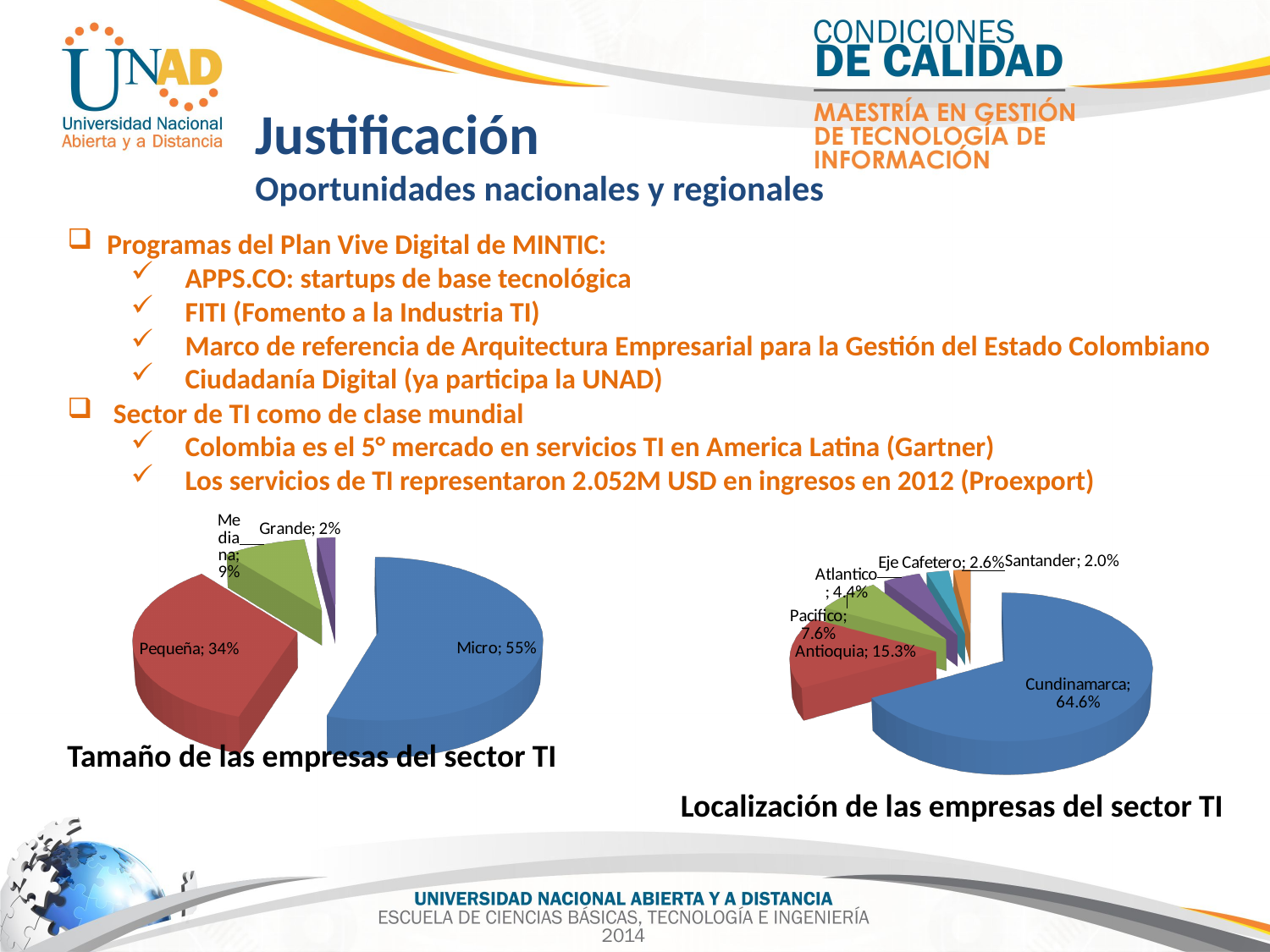
In the 'Tamaño de las empresas del sector TI' chart, what is the value for Pequeña? 34% In the 'Tamaño de las empresas del sector TI' chart, what is the difference between the Micro and Pequeña shares? 21% In the 'Localización de las empresas del sector TI' chart, how many regions are shown? 6 What kind of chart is 'Tamaño de las empresas del sector TI'? Pie chart In the 'Localización de las empresas del sector TI' chart, which region has the smallest share? Santander In the 'Localización de las empresas del sector TI' chart, what is the value for Cundinamarca? 64.6% In the 'Tamaño de las empresas del sector TI' chart, how many categories are shown? 4 In the 'Tamaño de las empresas del sector TI' chart, what share do Micro companies have? 55% In the 'Localización de las empresas del sector TI' chart, what is the value for Antioquia? 15.3% In the 'Localización de las empresas del sector TI' chart, which is larger, Pacifico or Atlantico? Pacifico In the 'Tamaño de las empresas del sector TI' chart, which category has the smallest slice? Grande In the 'Localización de las empresas del sector TI' chart, which region has the largest share? Cundinamarca